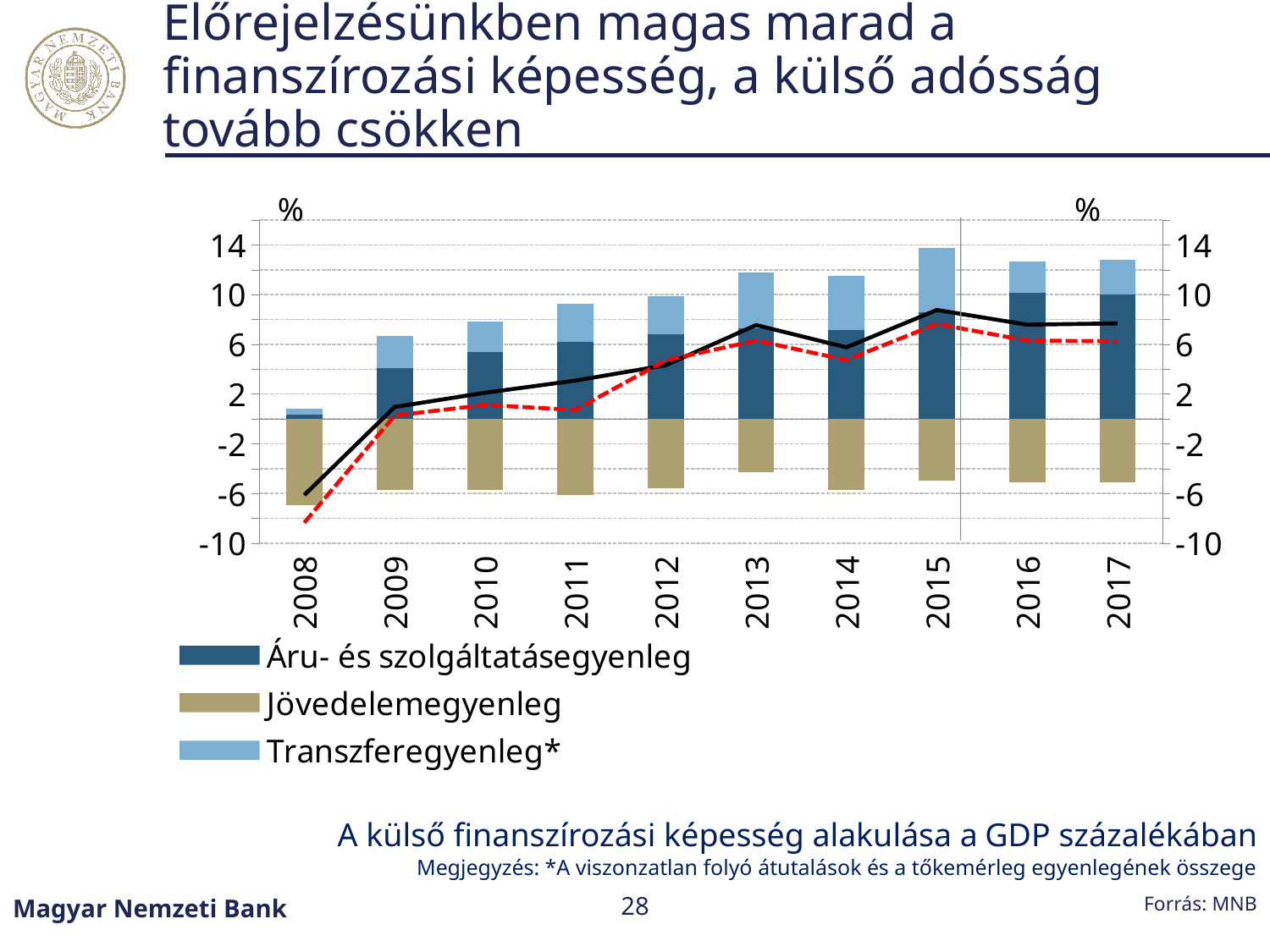
Is the value for Jövedelemegyenleg in 2013 greater or less than -2? less Which is larger, the Transzferegyenleg* value in 2015 or in 2016? 2015 Does the Áru- és szolgáltatásegyenleg series generally rise or fall from 2008 to 2017? Rise Is the value for Áru- és szolgáltatásegyenleg in 2016 greater or less than 6? greater Is the value for Áru- és szolgáltatásegyenleg in 2008 greater or less than 2? less Which year has the highest value for Transzferegyenleg*? 2015 What kind of chart is shown on the slide? Stacked bar chart (with line overlays) How many years are shown on the x axis of the chart? 10 Which year has the lowest value for Áru- és szolgáltatásegyenleg? 2008 What unit is shown on the chart's vertical axes? % Which is larger, the Áru- és szolgáltatásegyenleg value in 2016 or in 2009? 2016 How many series does the chart's legend list? 3